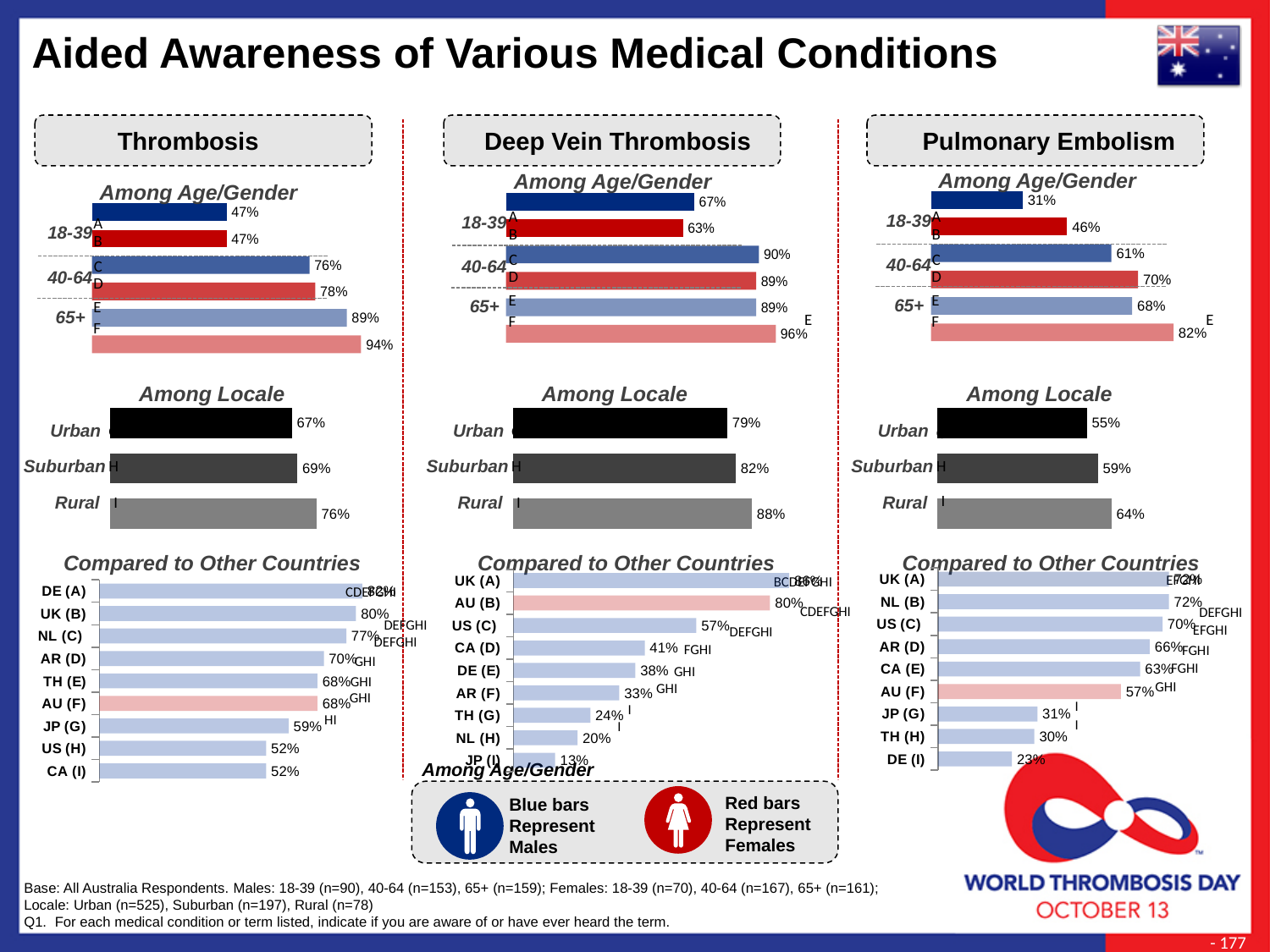
In the Pulmonary Embolism 'Among Age/Gender' chart, what is the value for bar A (males 18-39)? 31% In the Pulmonary Embolism 'Among Locale' chart, which locale has the lowest value? Urban According to the legend, what do the red bars represent? Females What type of chart is used for the 'Among Locale' sections? bar chart In the Pulmonary Embolism 'Among Age/Gender' chart, which is larger, bar C (males 40-64) or bar D (females 40-64)? D (females 40-64) How many countries are listed in the Pulmonary Embolism 'Compared to Other Countries' chart? 9 In the Deep Vein Thrombosis 'Among Age/Gender' chart, what is the value for bar F (females 65+)? 96% In the Deep Vein Thrombosis 'Compared to Other Countries' chart, what is the value for JP (I)? 13% In the Thrombosis 'Among Locale' chart, do the values rise or fall from Urban to Rural? rise In the Deep Vein Thrombosis 'Among Locale' chart, what is the difference between Rural and Urban? 9% In the Thrombosis 'Compared to Other Countries' chart, what is the value for AU (F)? 68% In the Thrombosis 'Among Locale' chart, what is the value for Rural? 76%